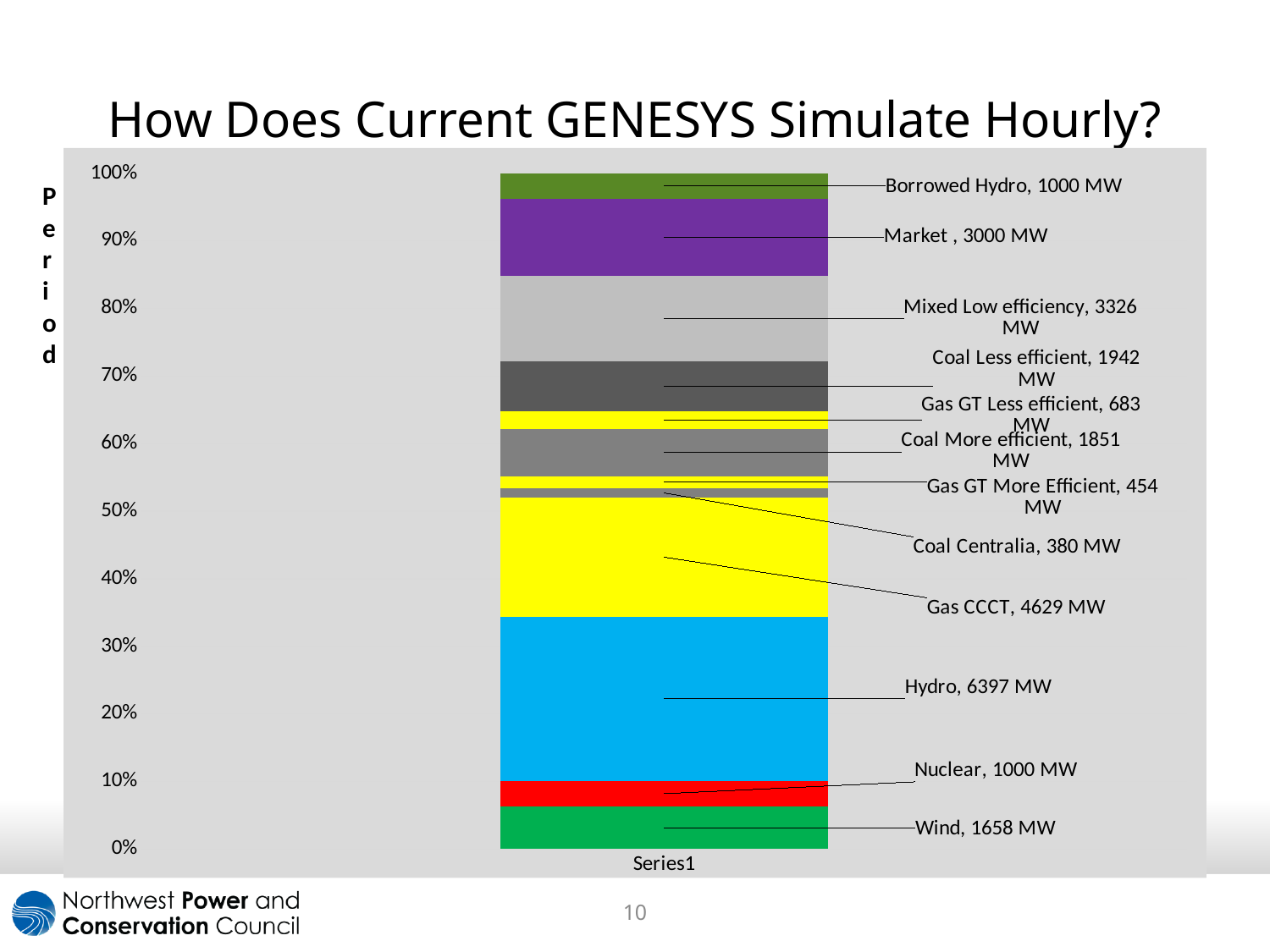
How many segments make up the stacked bar? 12 What kind of chart is shown on the slide? Stacked bar chart Which segment of the stacked bar has the smallest value? Coal Centralia What is the difference between the Hydro value and the Gas CCCT value? 1768 MW What is the value shown for Gas CCCT? 4629 MW What label appears under the bar on the horizontal axis? Series1 What is the value shown for Mixed Low efficiency? 3326 MW What is the total of all segments in the stacked bar? 26320 MW Which is larger, Market or Mixed Low efficiency? Mixed Low efficiency What is the value shown for Wind? 1658 MW Which segment of the stacked bar has the largest value? Hydro What is the value shown for Hydro? 6397 MW